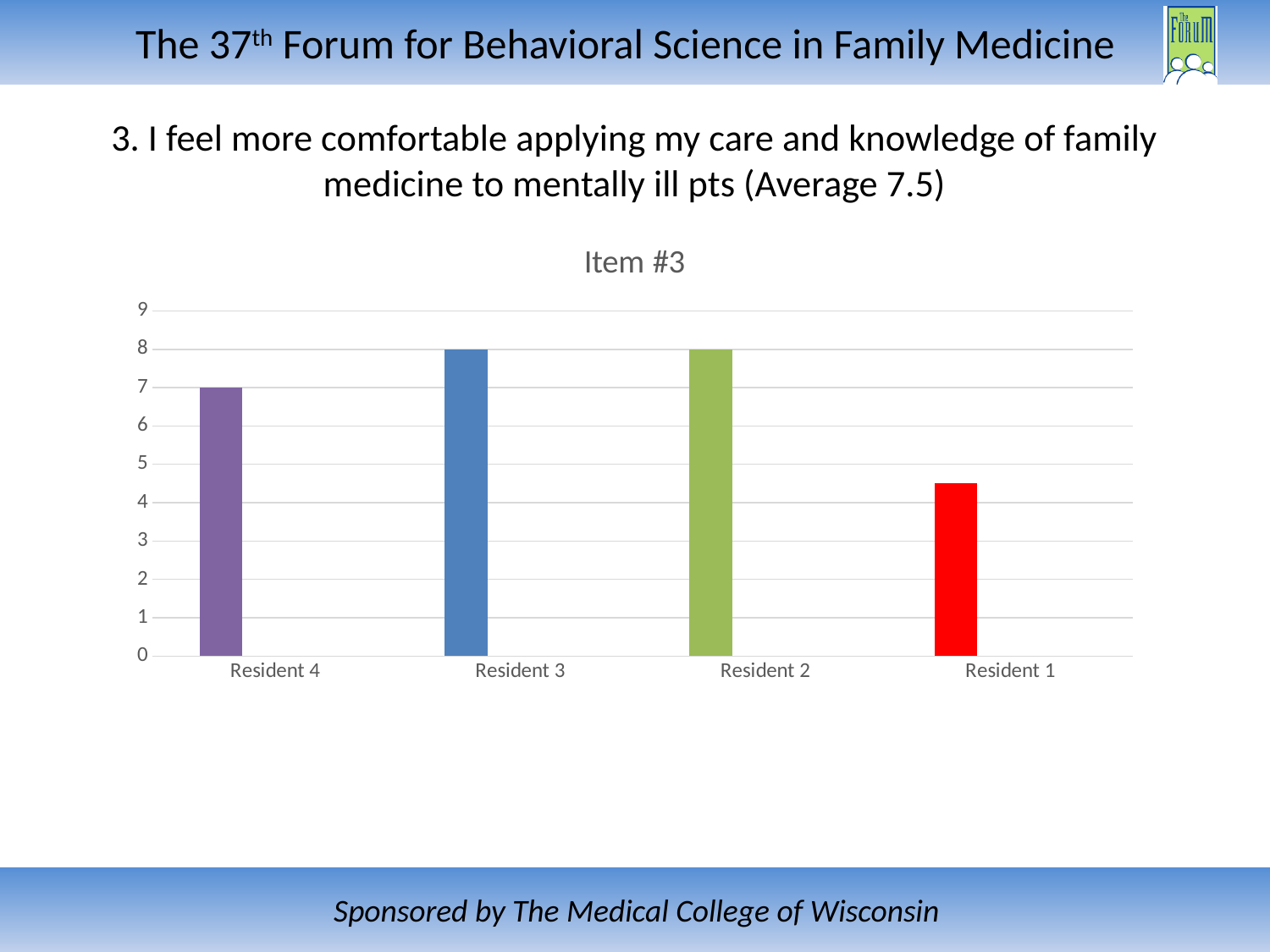
What kind of chart is shown on the slide? bar chart Which resident has the lowest value? Resident 1 How many residents are shown on the chart? 4 Is the value for Resident 1 greater or less than 4? greater What is the title of the chart? Item #3 What is the difference between the values for Resident 3 and Resident 4? 1 Which is larger, the value for Resident 4 or the value for Resident 1? Resident 4 What is the value for Resident 2? 8 What is the value for Resident 3? 8 What colour is the bar for Resident 1? red Is the value for Resident 1 greater or less than 5? less What is the value for Resident 4? 7